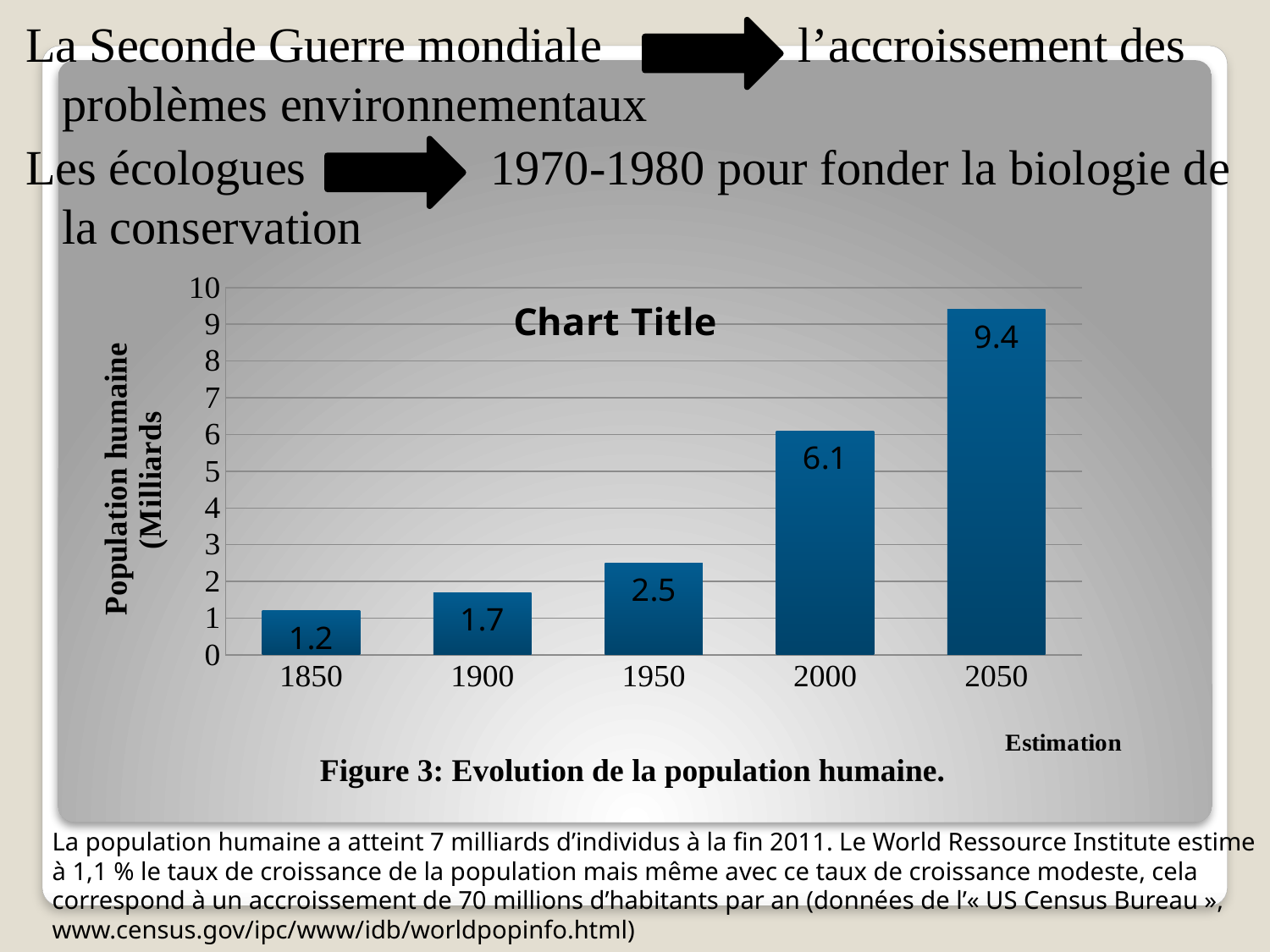
Which year has the lowest value? 1850 Is the value for 2000 greater or less than 5? greater What is the value for 1950? 2.5 What is the difference between the values for 1900 and 1850? 0.5 What is the value for 2000? 6.1 Which is larger, the value for 1950 or the value for 1900? 1950 What is the difference between the values for 2050 and 2000? 3.3 Which year has the highest value? 2050 How many years are shown on the x axis? 5 What kind of chart is this? bar chart Do the values rise or fall from 1850 to 2050? rise What is the value for 1850? 1.2